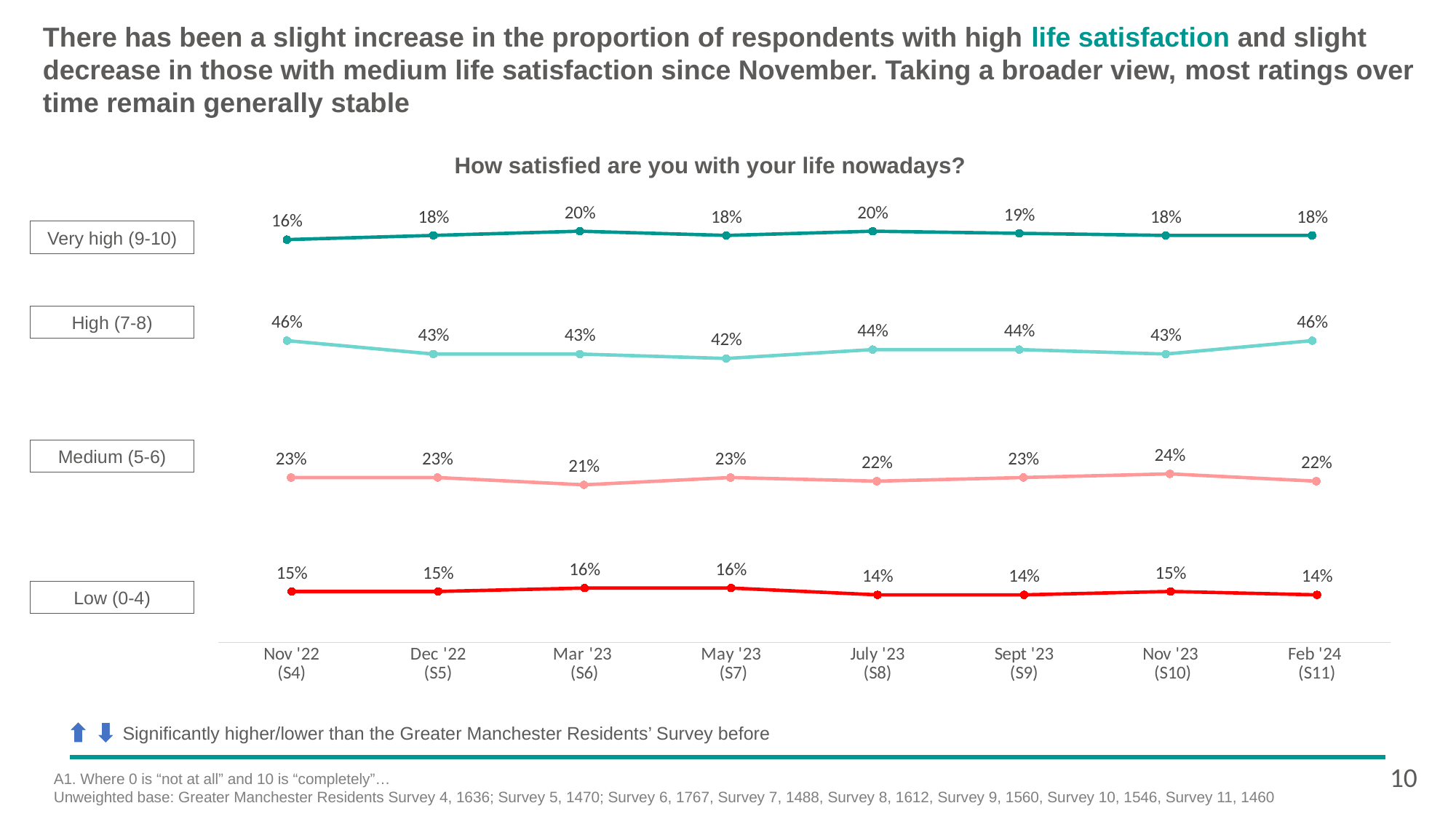
Which is larger in Feb '24 (S11): the Medium (5-6) value or the Low (0-4) value? Medium (5-6) What is the value for Very high (9-10) in Feb '24 (S11)? 18% What is the title of the chart? How satisfied are you with your life nowadays? What type of chart is shown on the slide? Line chart What is the value for High (7-8) in May '23 (S7)? 42% What is the value for Medium (5-6) in Nov '23 (S10)? 24% What is the value for Low (0-4) in Mar '23 (S6)? 16% How many series (satisfaction bands) are plotted on the chart? 4 In which survey wave is the High (7-8) series at its lowest? May '23 (S7) In which survey wave is the Medium (5-6) series at its highest? Nov '23 (S10) How many survey waves are shown on the x axis? 8 What is the difference between the High (7-8) value and the Very high (9-10) value in Nov '22 (S4)? 30%